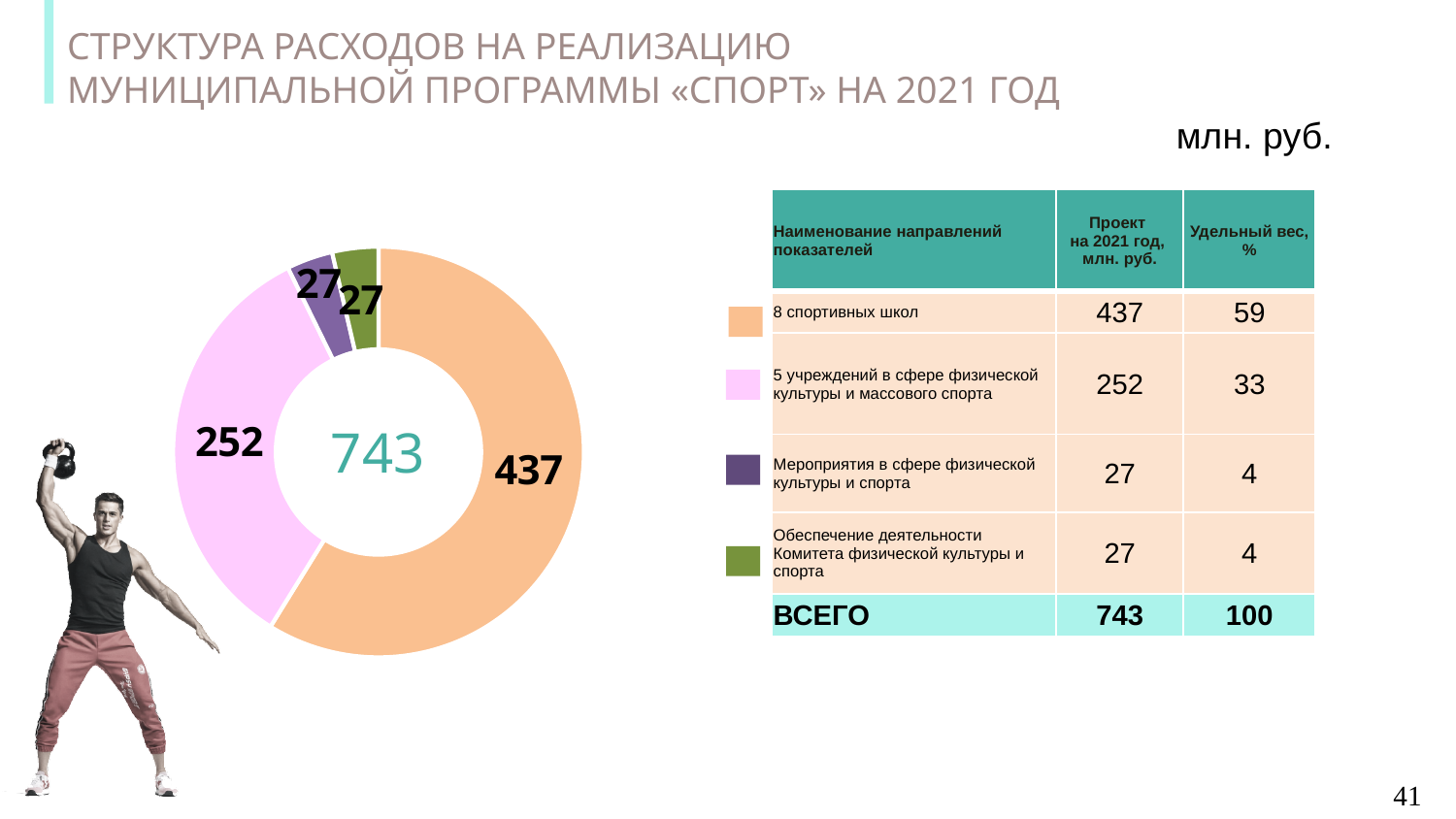
What kind of chart is shown on the slide? Donut (pie) chart What total is shown in the centre of the donut chart? 743 What value is shown for the segment "8 спортивных школ" (orange) in the donut chart? 437 What unit of measurement is indicated for the values in the chart? млн. руб. What value is shown for the segment "Мероприятия в сфере физической культуры и спорта" (purple) in the donut chart? 27 Which is larger: the value for "5 учреждений в сфере физической культуры и массового спорта" or the value for "Мероприятия в сфере физической культуры и спорта"? 5 учреждений в сфере физической культуры и массового спорта What is the difference between the values for "8 спортивных школ" and "5 учреждений в сфере физической культуры и массового спорта"? 185 What value is shown for the segment "5 учреждений в сфере физической культуры и массового спорта" (pink) in the donut chart? 252 What share of the total does the segment "8 спортивных школ" represent, according to the table? 59 What share of the total does the segment "5 учреждений в сфере физической культуры и массового спорта" represent, according to the table? 33 How many segments does the donut chart have? 4 Which segment of the donut chart has the largest value? 8 спортивных школ